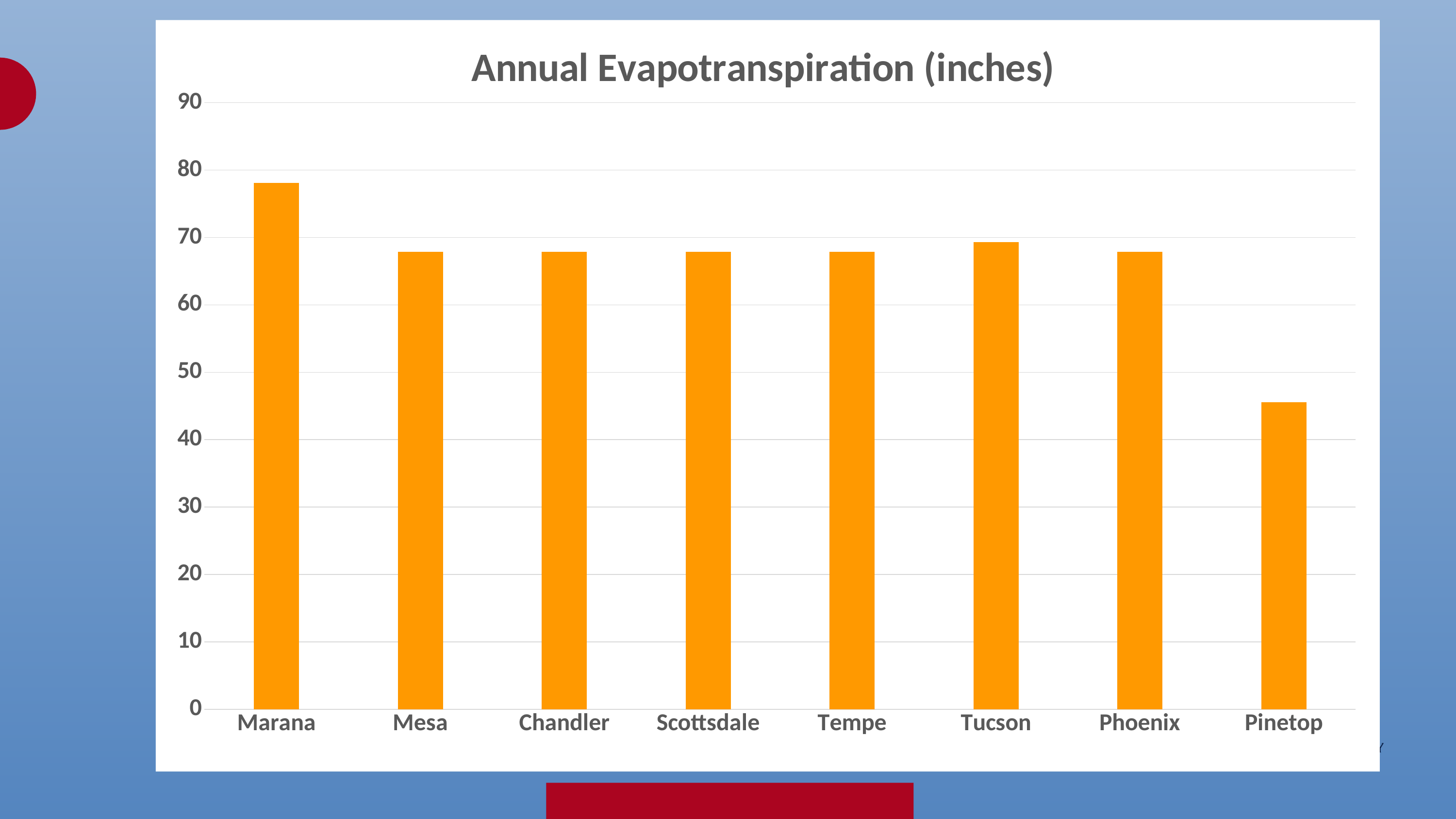
Is the value for Mesa greater or less than 60? greater How many cities are shown on the x axis of the chart? 8 Is the value for Pinetop greater or less than 50? less Which city has the lowest annual evapotranspiration? Pinetop What is the title of the chart? Annual Evapotranspiration (inches) Which is larger, the value for Pinetop or the value for Phoenix? Phoenix Which city has the highest annual evapotranspiration? Marana What kind of chart is shown on the slide? bar chart Is the value for Marana greater or less than 70? greater Which is larger, the value for Marana or the value for Mesa? Marana What colour are the bars in the chart? orange